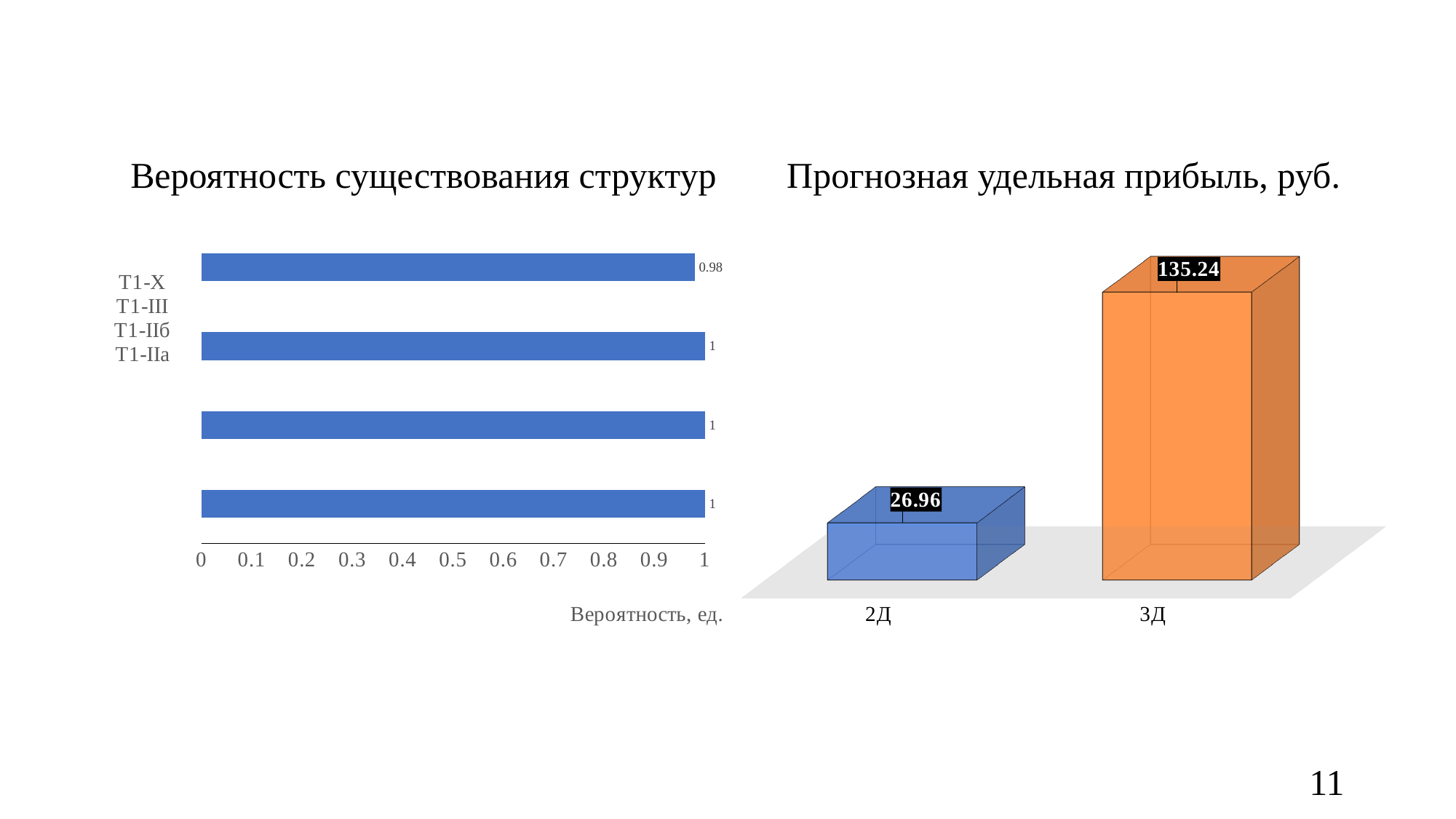
In the chart titled 'Прогнозная удельная прибыль, руб.', what is the difference between the values for 3Д and 2Д? 108.28 In the chart titled 'Прогнозная удельная прибыль, руб.', what is the value for 2Д? 26.96 In the chart titled 'Прогнозная удельная прибыль, руб.', which category has the lowest value? 2Д In the chart titled 'Вероятность существования структур', what is the lowest value shown on any bar? 0.98 In the chart titled 'Прогнозная удельная прибыль, руб.', which category has the highest value? 3Д What kind of chart is the one titled 'Вероятность существования структур'? bar chart In the chart titled 'Вероятность существования структур', what is the value labelled on the topmost bar? 0.98 In the chart titled 'Вероятность существования структур', how many bars are plotted? 4 In the chart titled 'Прогнозная удельная прибыль, руб.', what is the value for 3Д? 135.24 In the chart titled 'Прогнозная удельная прибыль, руб.', how many categories are shown? 2 In the chart titled 'Прогнозная удельная прибыль, руб.', which is larger, the value for 2Д or the value for 3Д? 3Д What kind of chart is the one titled 'Прогнозная удельная прибыль, руб.'? bar chart